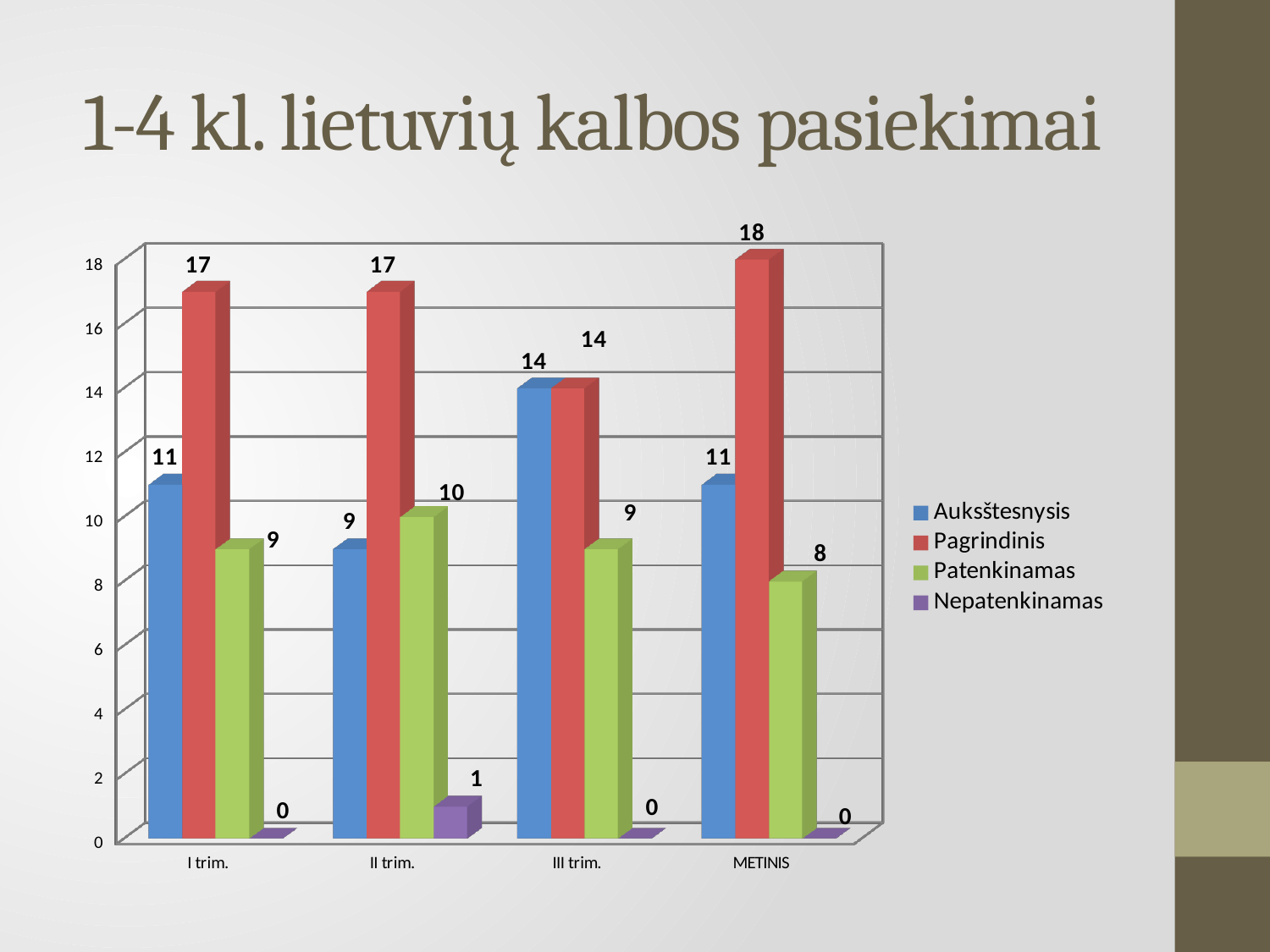
How many series does the legend list? 4 In which category is the Aukštesnysis value lowest? II trim. How many categories are shown on the x axis? 4 What kind of chart is shown on the slide? Bar chart In which category is the Pagrindinis value highest? METINIS What is the value for Patenkinamas in METINIS? 8 Which is larger in II trim., Aukštesnysis or Patenkinamas? Patenkinamas What is the title of the slide? 1-4 kl. lietuvių kalbos pasiekimai What is the value for Pagrindinis in METINIS? 18 What is the difference between Pagrindinis and Aukštesnysis in I trim.? 6 What is the value for Nepatenkinamas in II trim.? 1 What is the value for Aukštesnysis in III trim.? 14